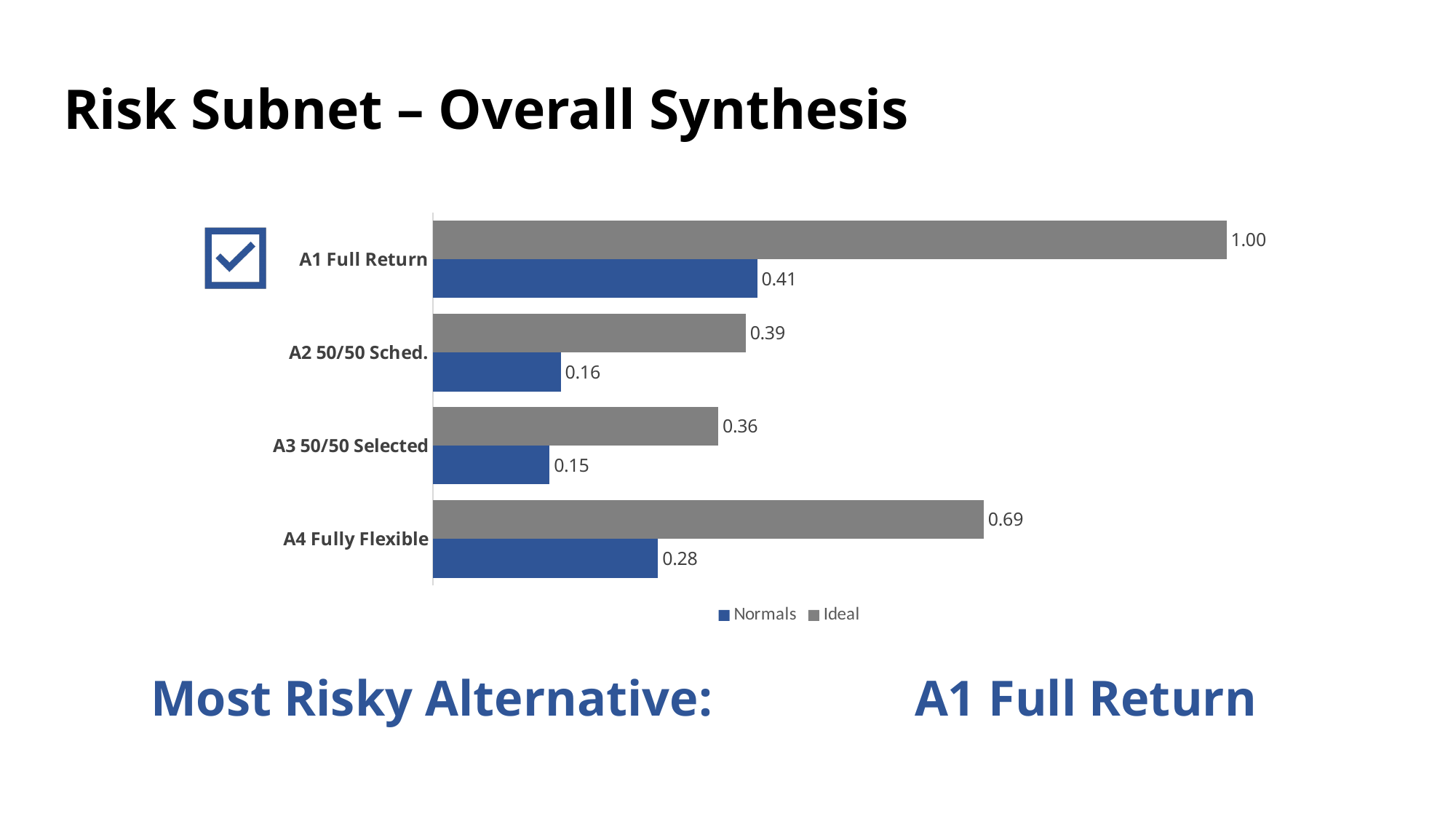
What is the Normals value for A2 50/50 Sched.? 0.16 Which category has the highest Normals value? A1 Full Return What kind of chart is shown on the slide? Bar chart How many series does the legend list? 2 Which series is shown in grey in the legend? Ideal What is the Normals value for A3 50/50 Selected? 0.15 How many categories are shown on the chart? 4 Which is larger, the Ideal value for A4 Fully Flexible or the Ideal value for A2 50/50 Sched.? A4 Fully Flexible What is the difference between the Ideal and Normals values for A1 Full Return? 0.59 Which category has the lowest Ideal value? A3 50/50 Selected What is the Ideal value for A1 Full Return? 1.00 What is the Ideal value for A4 Fully Flexible? 0.69